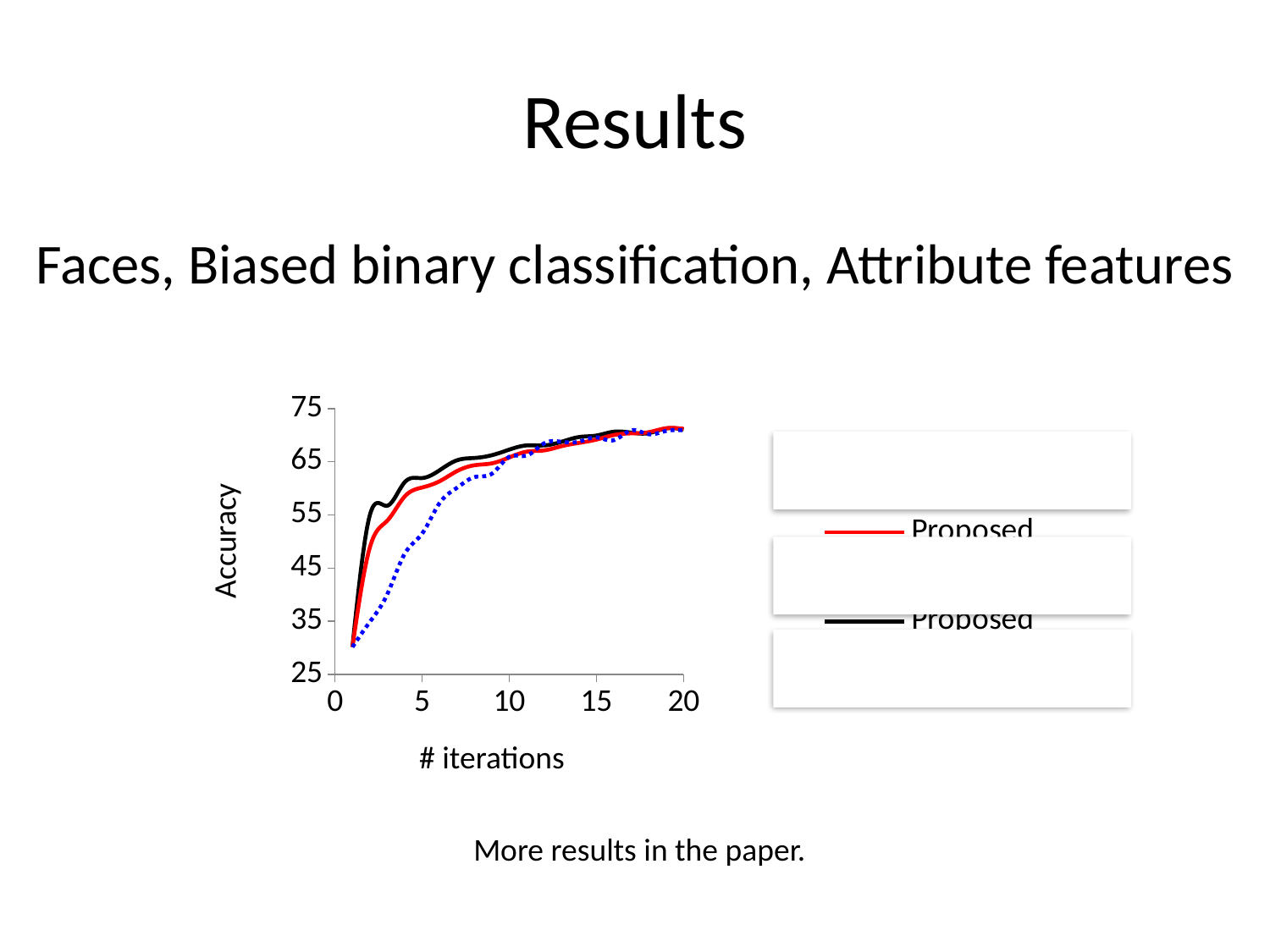
Is the accuracy of the blue dotted line at 5 iterations greater or less than 55? less How many lines are plotted on the chart? 3 Is the accuracy of the black line at 20 iterations greater or less than 65? greater What is the label of the x axis of the chart? # iterations At 3 iterations, which line has the higher accuracy, the black line or the red line? black line What is the label of the y axis of the chart? Accuracy Is the accuracy of the black line at 5 iterations greater or less than 55? greater Do the accuracy values rise or fall as the number of iterations increases? rise At 5 iterations, which line has the higher accuracy, the black line or the blue dotted line? black line What kind of chart is shown on the slide? line chart Which line has the lowest accuracy at 5 iterations? blue dotted line